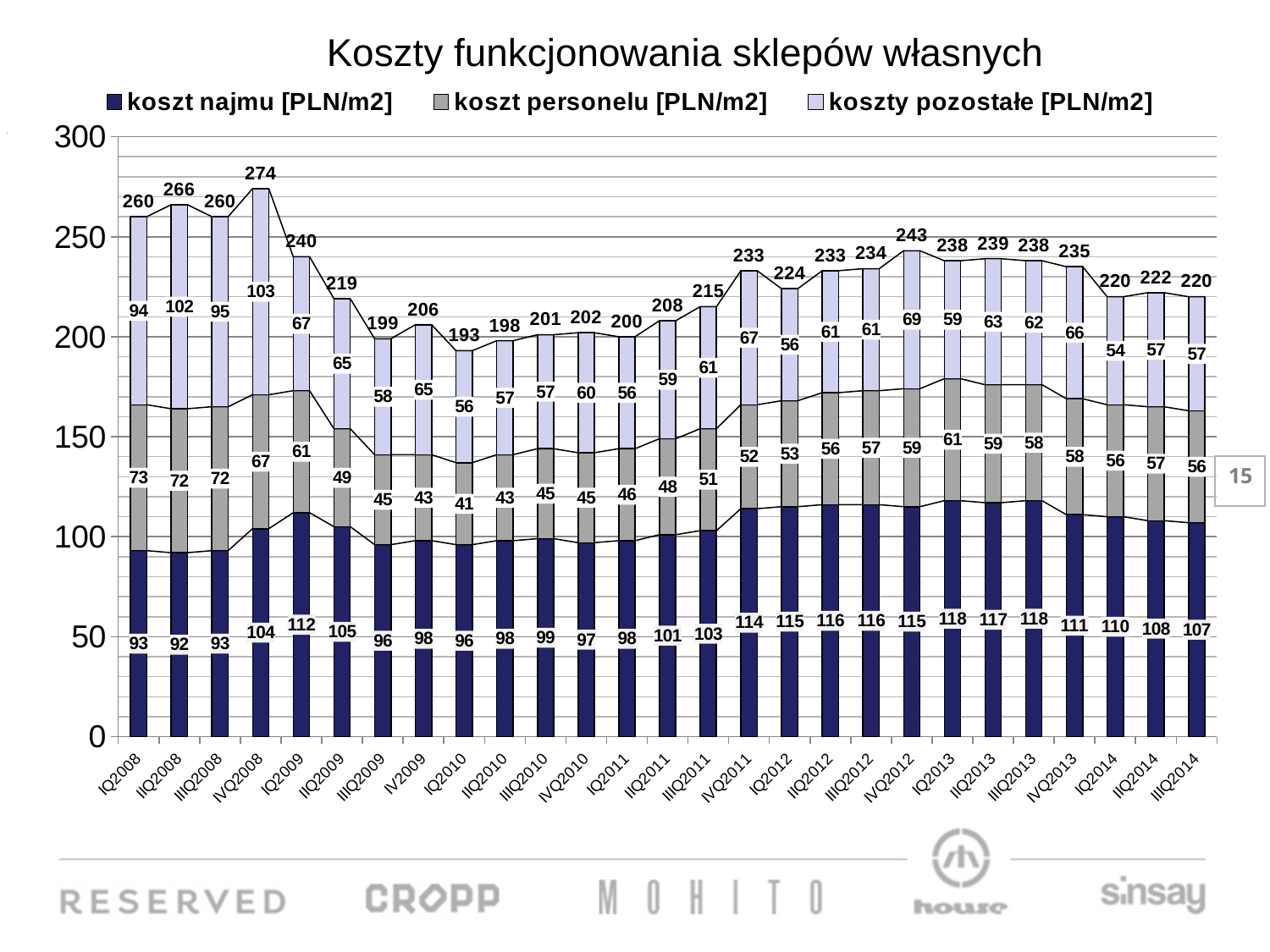
What is the value of koszt najmu [PLN/m2] for IQ2009? 112 Which quarter has the lowest total cost? IQ2010 What is the value of koszty pozostałe [PLN/m2] for IVQ2012? 69 What is the title of the chart? Koszty funkcjonowania sklepów własnych What is the value of koszt personelu [PLN/m2] for IIIQ2014? 56 How many series does the legend list? 3 Which is larger: koszt najmu [PLN/m2] for IQ2008 or koszt najmu [PLN/m2] for IQ2014? IQ2014 What is the total of the stacked bar for IIQ2012? 233 How many quarters are shown on the x axis? 27 What is the difference between the total cost for IVQ2008 and the total cost for IQ2010? 81 Which quarter has the highest total cost? IVQ2008 What kind of chart is shown on the slide? stacked bar chart